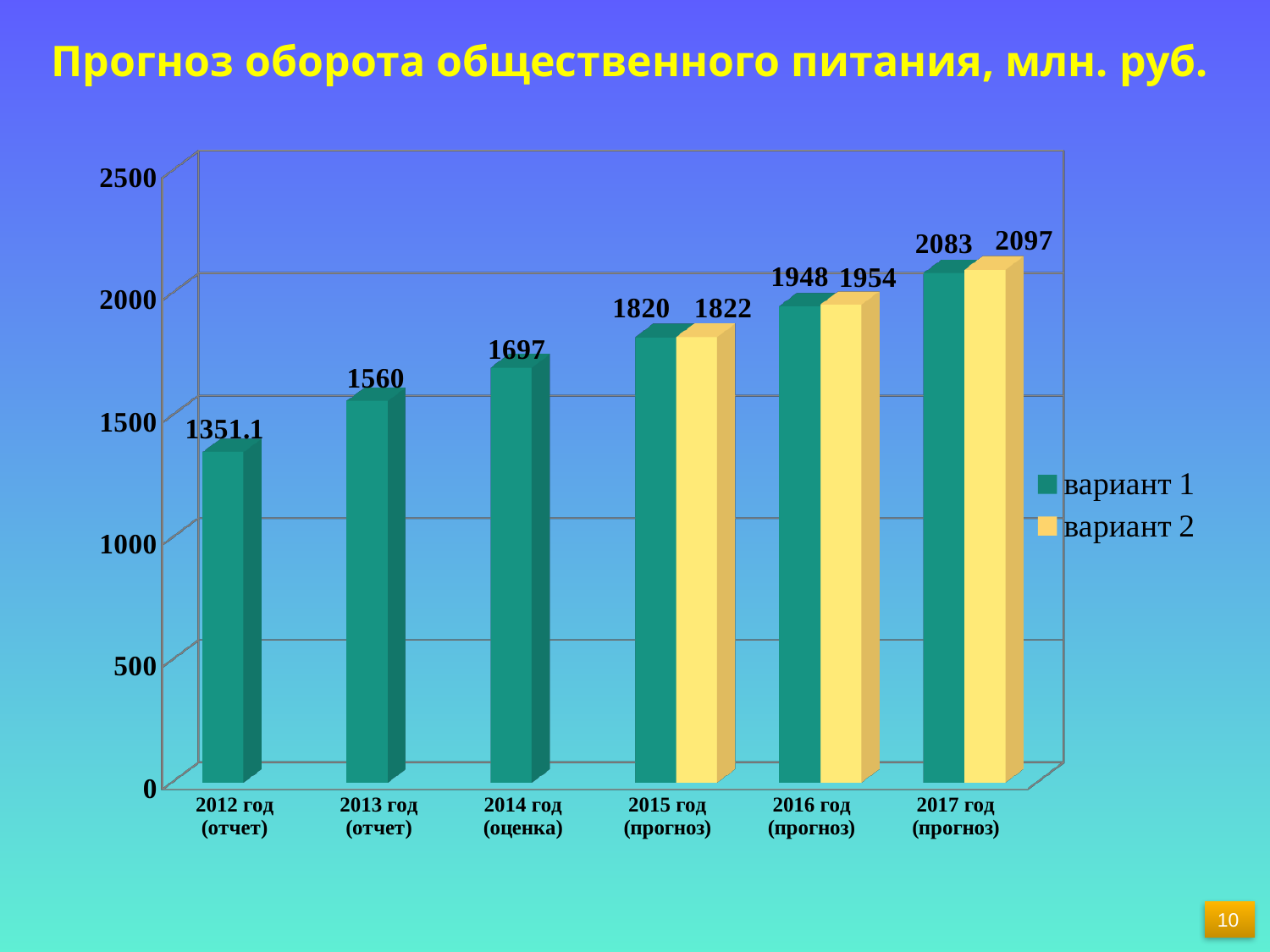
Do the вариант 1 values rise or fall from 2012 год (отчет) to 2017 год (прогноз)? rise How many categories are shown on the x axis? 6 What kind of chart is shown on the slide? bar chart What is the difference between вариант 2 and вариант 1 in 2017 год (прогноз)? 14 Which category has the highest value for вариант 1? 2017 год (прогноз) What is the value for вариант 1 in 2014 год (оценка)? 1697 What is the value for вариант 1 in 2012 год (отчет)? 1351.1 What is the difference between the вариант 1 values for 2013 год (отчет) and 2012 год (отчет)? 208.9 Which is larger: вариант 1 in 2015 год (прогноз) or вариант 1 in 2016 год (прогноз)? вариант 1 in 2016 год (прогноз) What is the value for вариант 2 in 2016 год (прогноз)? 1954 Which category has the lowest value for вариант 1? 2012 год (отчет) How many series does the legend list? 2